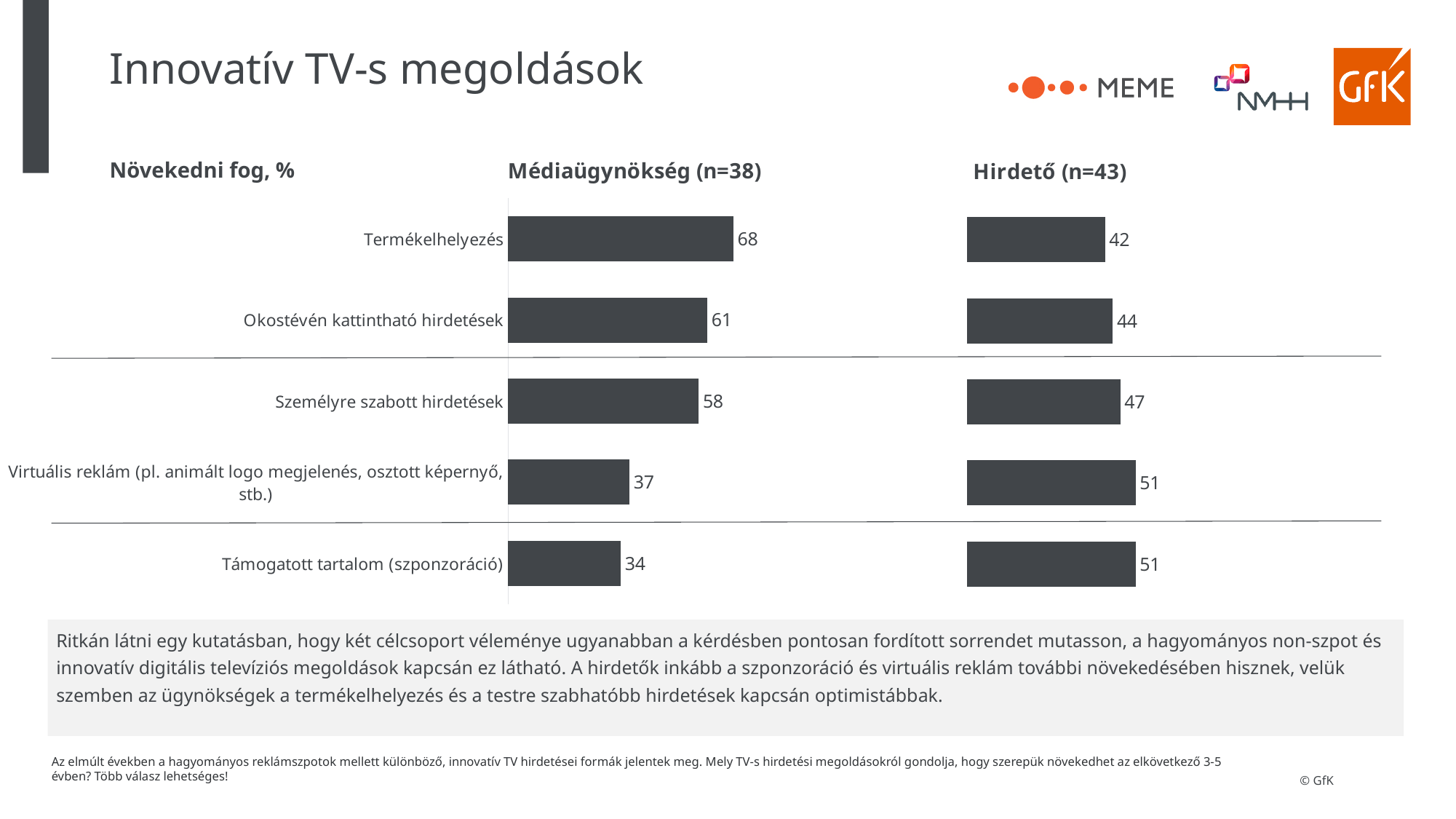
In the Médiaügynökség (n=38) chart, which category has the highest value? Termékelhelyezés In the Médiaügynökség (n=38) chart, what is the value for Termékelhelyezés? 68 What is the difference between the Médiaügynökség (n=38) value and the Hirdető (n=43) value for Termékelhelyezés? 26 In the Médiaügynökség (n=38) chart, what is the value for Támogatott tartalom (szponzoráció)? 34 For Virtuális reklám, which is larger: the Médiaügynökség (n=38) value or the Hirdető (n=43) value? Hirdető (n=43) In the Hirdető (n=43) chart, which category has the lowest value? Termékelhelyezés In the Hirdető (n=43) chart, what is the value for Személyre szabott hirdetések? 47 How many categories are shown in the Médiaügynökség (n=38) chart? 5 In the Médiaügynökség (n=38) chart, what is the difference between Termékelhelyezés and Okostévén kattintható hirdetések? 7 What kind of chart is the Hirdető (n=43) chart? Bar chart In the Hirdető (n=43) chart, what is the value for Okostévén kattintható hirdetések? 44 In the Médiaügynökség (n=38) chart, which category has the lowest value? Támogatott tartalom (szponzoráció)